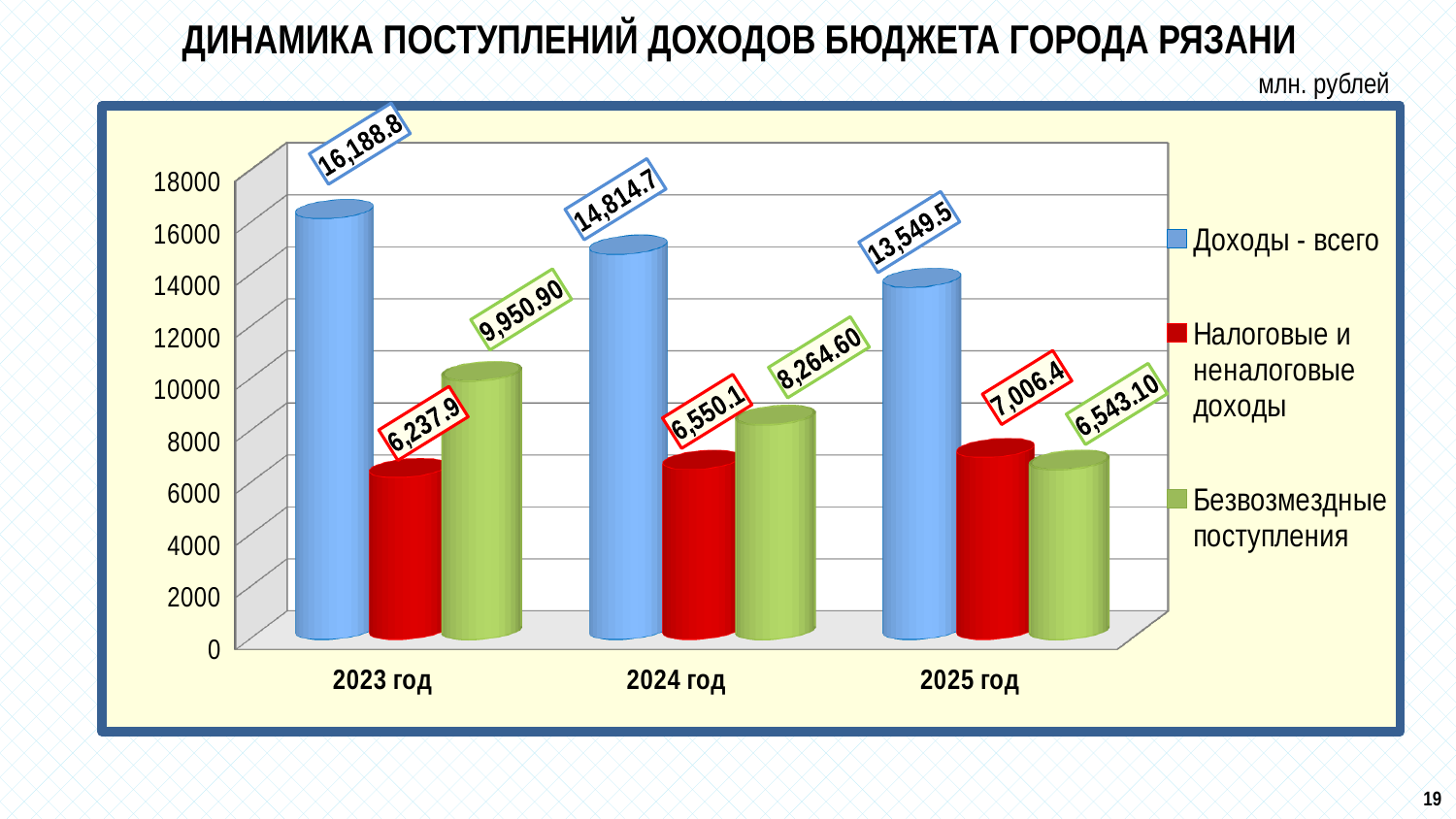
What is the value of Доходы - всего for 2023 год? 16,188.8 Does Доходы - всего rise or fall from 2023 год to 2025 год? fall In which year is Доходы - всего the highest? 2023 год Is the value of Доходы - всего for 2025 год greater or less than 14000? less What is the difference between Безвозмездные поступления in 2023 год and 2025 год? 3,407.80 What is the difference between Доходы - всего in 2023 год and 2024 год? 1,374.1 Which is larger in 2025 год: Налоговые и неналоговые доходы or Безвозмездные поступления? Налоговые и неналоговые доходы How many series does the legend list? 3 What is the value of Безвозмездные поступления for 2024 год? 8,264.60 In which year is Безвозмездные поступления the lowest? 2025 год What kind of chart is shown on the slide? bar chart What is the value of Налоговые и неналоговые доходы for 2025 год? 7,006.4